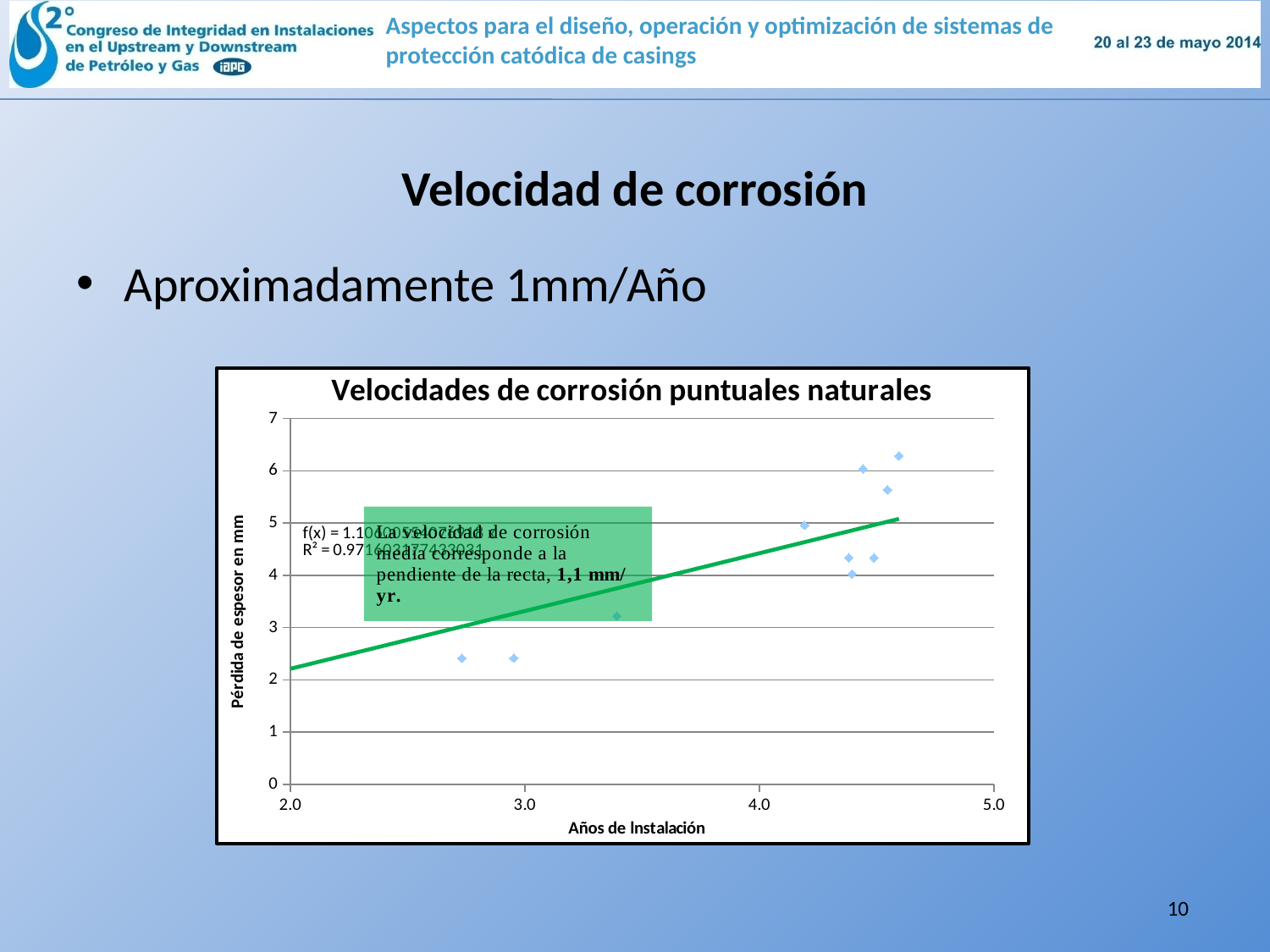
What is the label of the x axis of the chart? Años de Instalación Do the plotted values generally rise or fall as the years of installation increase? Rise Are the lowest plotted points on the chart greater or less than 3 mm? less According to the text box on the chart, what is the mean corrosion rate given by the slope of the line? 1,1 mm/yr What kind of chart is shown on the slide? Scatter chart Is the value of the trend line at 2.0 years greater or less than 3 mm? less Is the value of the trend line at 4.0 years greater or less than 4 mm? greater Which is larger: the plotted value at about 3.4 years or the plotted value at about 4.2 years? The value at about 4.2 years What is the maximum value shown on the y axis of the chart? 7 What is the title of the chart? Velocidades de corrosión puntuales naturales